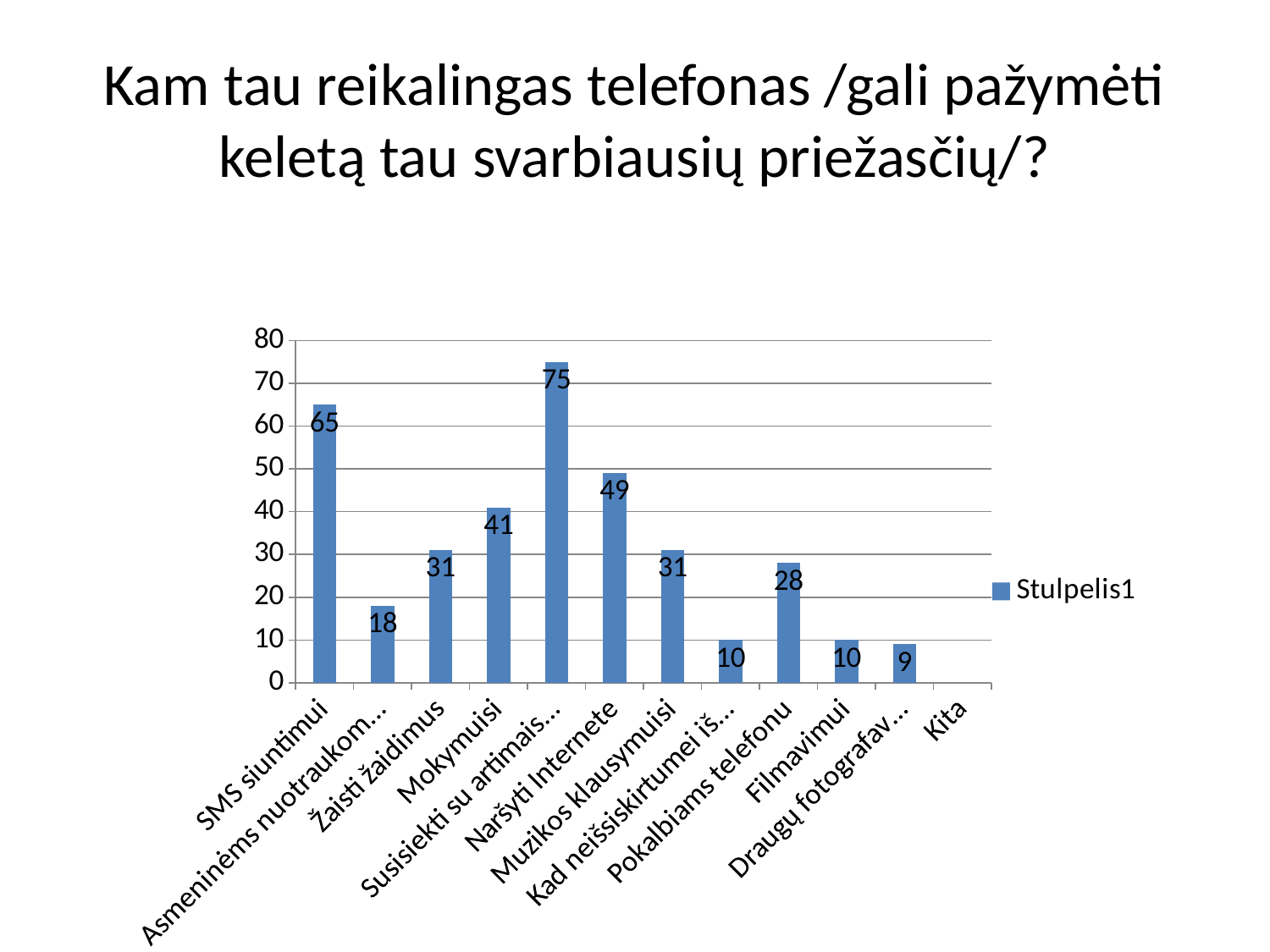
What is the value for Filmavimui? 10 What is the value for Naršyti Internete? 49 What type of chart is shown on the slide? bar chart What is the value for Pokalbiams telefonu? 28 What is the value for Mokymuisi? 41 What is the difference between the values for SMS siuntimui and Naršyti Internetе? 16 What is the name of the series shown in the legend? Stulpelis1 Which has a larger value, Pokalbiams telefonu or Filmavimui? Pokalbiams telefonu Which has a larger value, Žaisti žaidimus or Mokymuisi? Mokymuisi What is the value for SMS siuntimui? 65 How many series does the legend list? 1 What is the highest value shown by any bar in the chart? 75